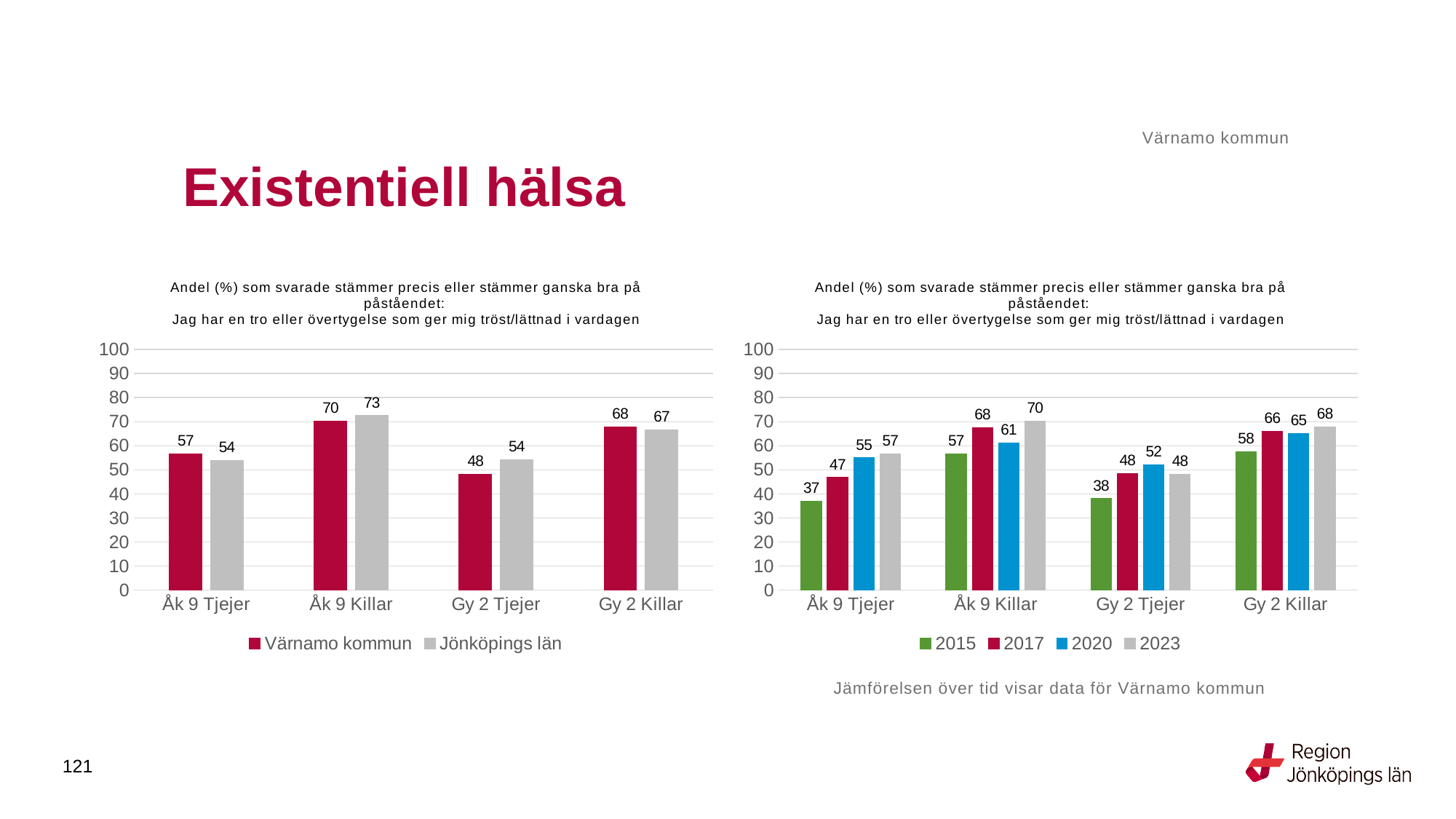
How many series does the legend of the left chart list? 2 In the left chart, what is the value for Jönköpings län for Gy 2 Tjejer? 54 In the right chart, what is the value for 2020 for Gy 2 Tjejer? 52 In the right chart, which category has the lowest value for 2015? Åk 9 Tjejer In the right chart, do the values for Åk 9 Tjejer rise or fall from 2015 to 2023? rise In the right chart, what is the value for 2015 for Åk 9 Tjejer? 37 In the left chart, which category has the highest value for Värnamo kommun? Åk 9 Killar In the left chart, what is the value for Värnamo kommun for Åk 9 Tjejer? 57 In the right chart, what is the difference between 2023 and 2015 for Åk 9 Tjejer? 20 In the left chart, which is larger for Gy 2 Killar: Värnamo kommun or Jönköpings län? Värnamo kommun In the left chart, what is the difference between Jönköpings län and Värnamo kommun for Åk 9 Killar? 3 What kind of chart is the right chart? bar chart